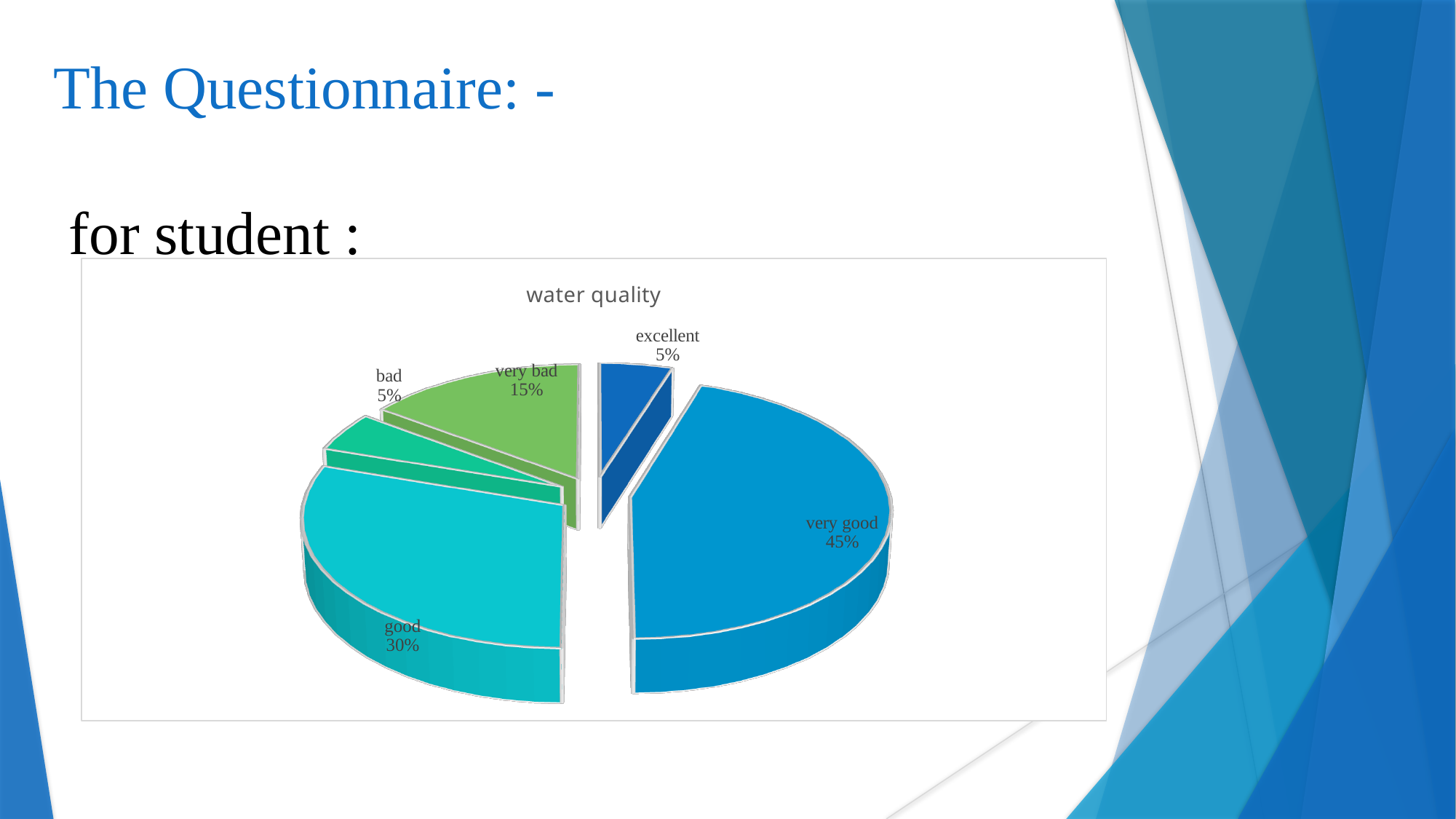
What percentage of students rated water quality as good? 30% What is the combined share of the very good and good slices? 75% What percentage of students rated water quality as very good? 45% How many categories are shown in the pie chart? 5 Which category has the largest share of the pie? very good What kind of chart is shown on the slide? pie chart Which two categories have the same share of 5%? excellent and bad What is the difference between the very good and good shares? 15% Which is larger, the share for very bad or the share for bad? very bad What is the title of the chart? water quality What percentage of students rated water quality as excellent? 5% What percentage of students rated water quality as very bad? 15%